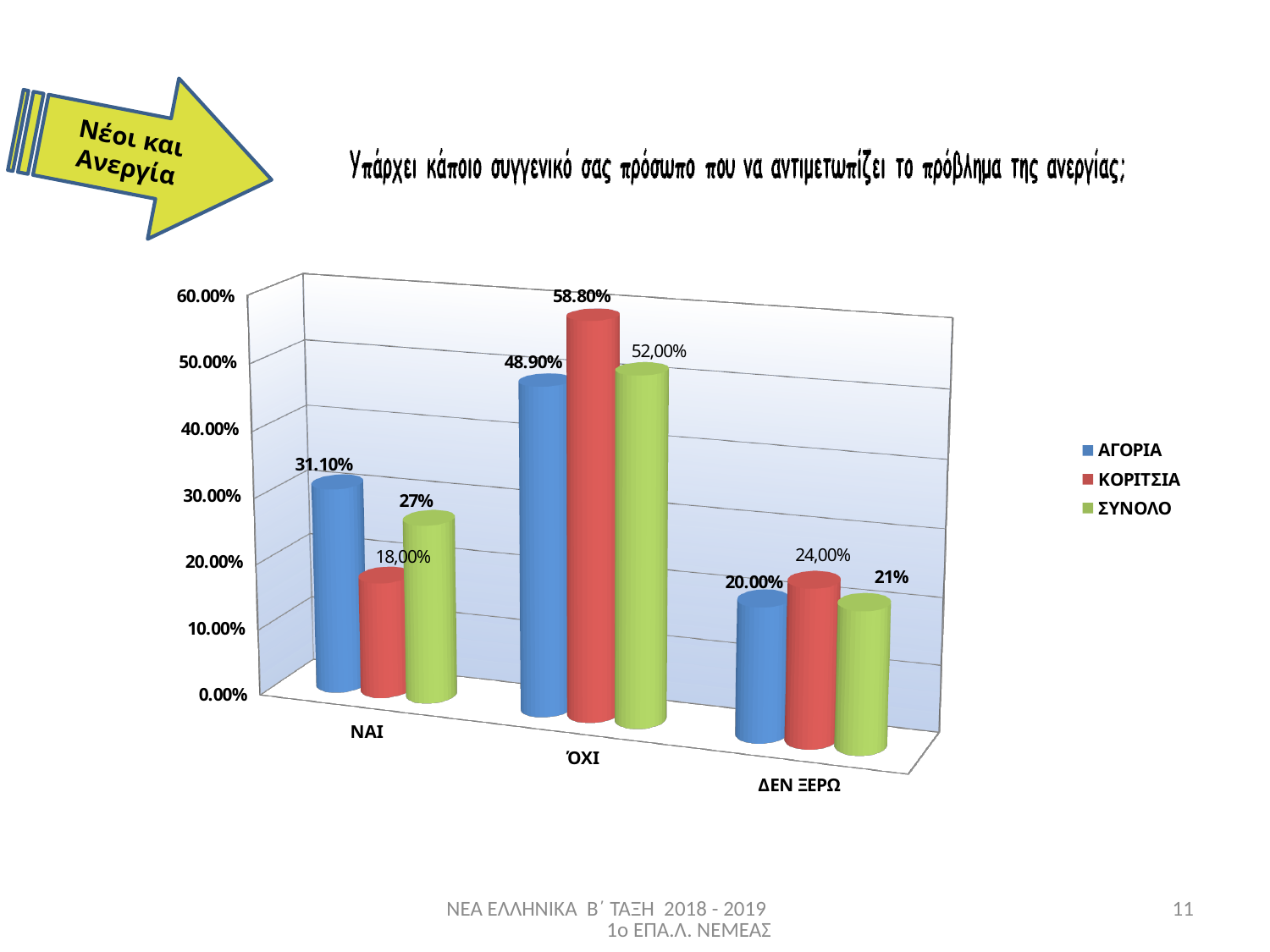
Which category has the lowest value for the ΚΟΡΙΤΣΙΑ series? ΝΑΙ What is the value for ΑΓΟΡΙΑ in the ΝΑΙ category? 31.10% How many series does the legend list? 3 What is the value for ΣΥΝΟΛΟ in the ΔΕΝ ΞΕΡΩ category? 21% In the ΝΑΙ category, which is larger: the ΑΓΟΡΙΑ value or the ΚΟΡΙΤΣΙΑ value? ΑΓΟΡΙΑ What kind of chart is shown on the slide? bar chart What is the difference between the ΚΟΡΙΤΣΙΑ and ΑΓΟΡΙΑ values in the ΌΧΙ category? 9.90% Which category has the highest value for the ΑΓΟΡΙΑ series? ΌΧΙ What is the value for ΚΟΡΙΤΣΙΑ in the ΌΧΙ category? 58.80% What is the value for ΚΟΡΙΤΣΙΑ in the ΝΑΙ category? 18,00% Is the value for ΣΥΝΟΛΟ in the ΌΧΙ category greater or less than 50.00%? greater How many categories are shown on the x axis? 3